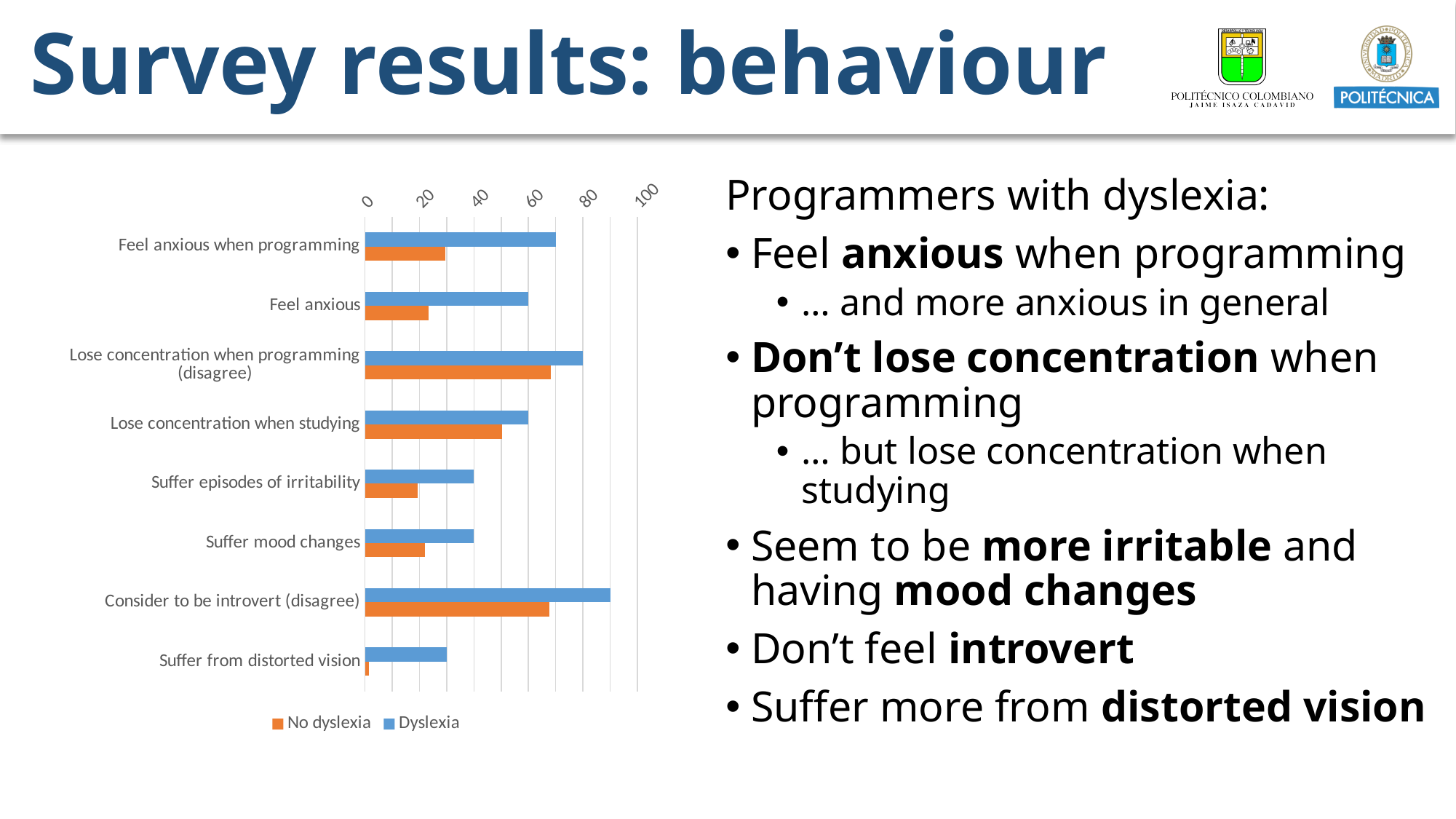
Which colour represents the No dyslexia series in the chart? Orange How many categories are plotted on the chart? 8 What kind of chart is shown on the slide? Bar chart Which category has the lowest value for the No dyslexia series? Suffer from distorted vision For 'Feel anxious when programming', which series has the larger value, Dyslexia or No dyslexia? Dyslexia Which category has the lowest value for the Dyslexia series? Suffer from distorted vision Which category has the highest value for the Dyslexia series? Consider to be introvert (disagree) Is the Dyslexia value for 'Consider to be introvert (disagree)' greater or less than 80? greater Is the No dyslexia value for 'Suffer episodes of irritability' greater or less than 40? less How many series does the chart legend list? 2 What is the highest value shown on the chart's value axis? 100 Is the Dyslexia value for 'Feel anxious when programming' greater or less than 60? greater